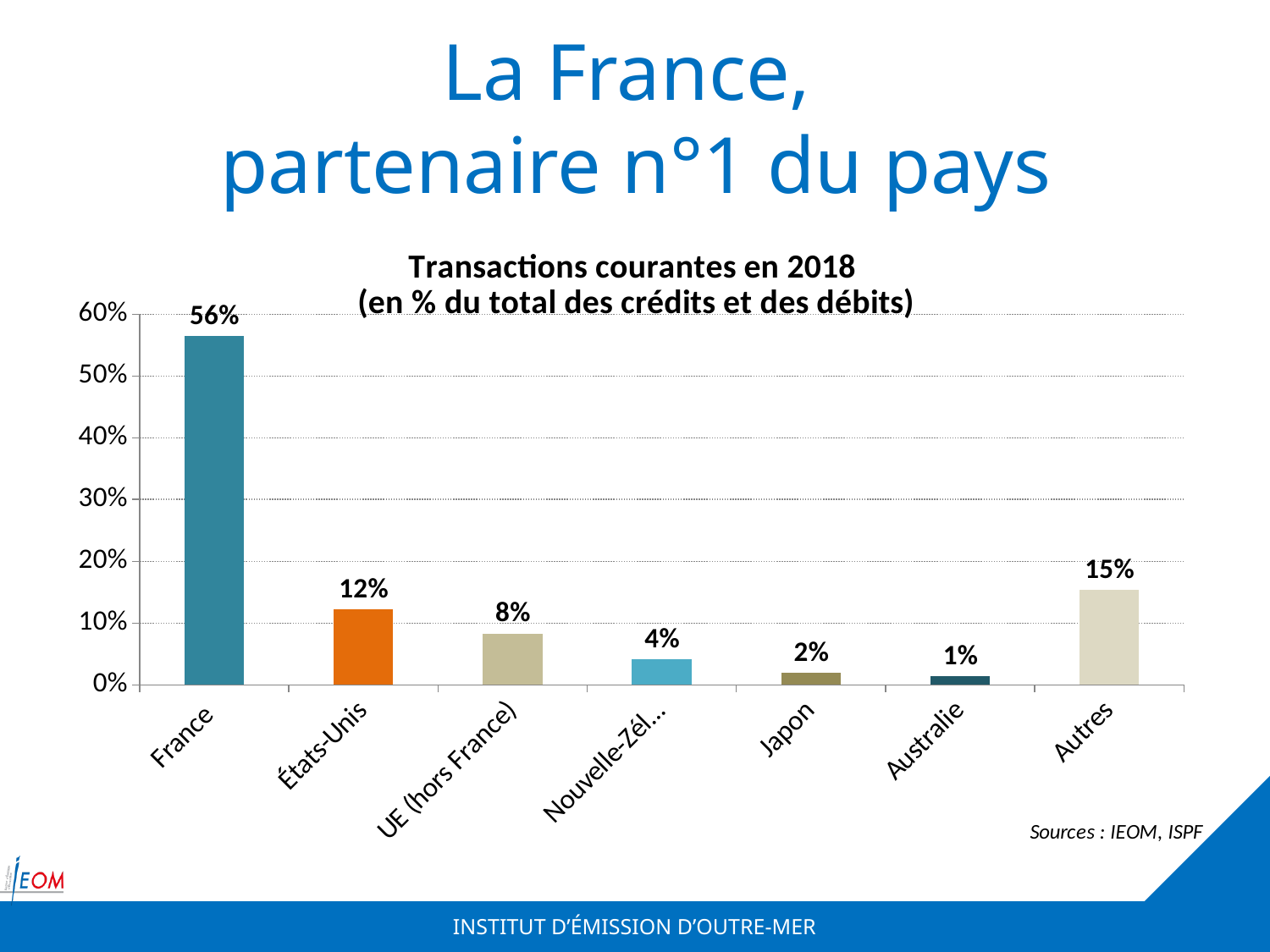
What is the value for États-Unis? 12% Which is larger, the value for UE (hors France) or the value for Autres? Autres What is the value for France? 56% Which category has the lowest value? Australie What is the title of the chart? Transactions courantes en 2018 (en % du total des crédits et des débits) Which category has the highest value? France What is the value for Japon? 2% Is the value for France greater or less than 50%? greater What is the difference between the values for France and États-Unis? 44% What is the value for Autres? 15% How many categories are shown on the x axis? 7 What kind of chart is shown on the slide? bar chart